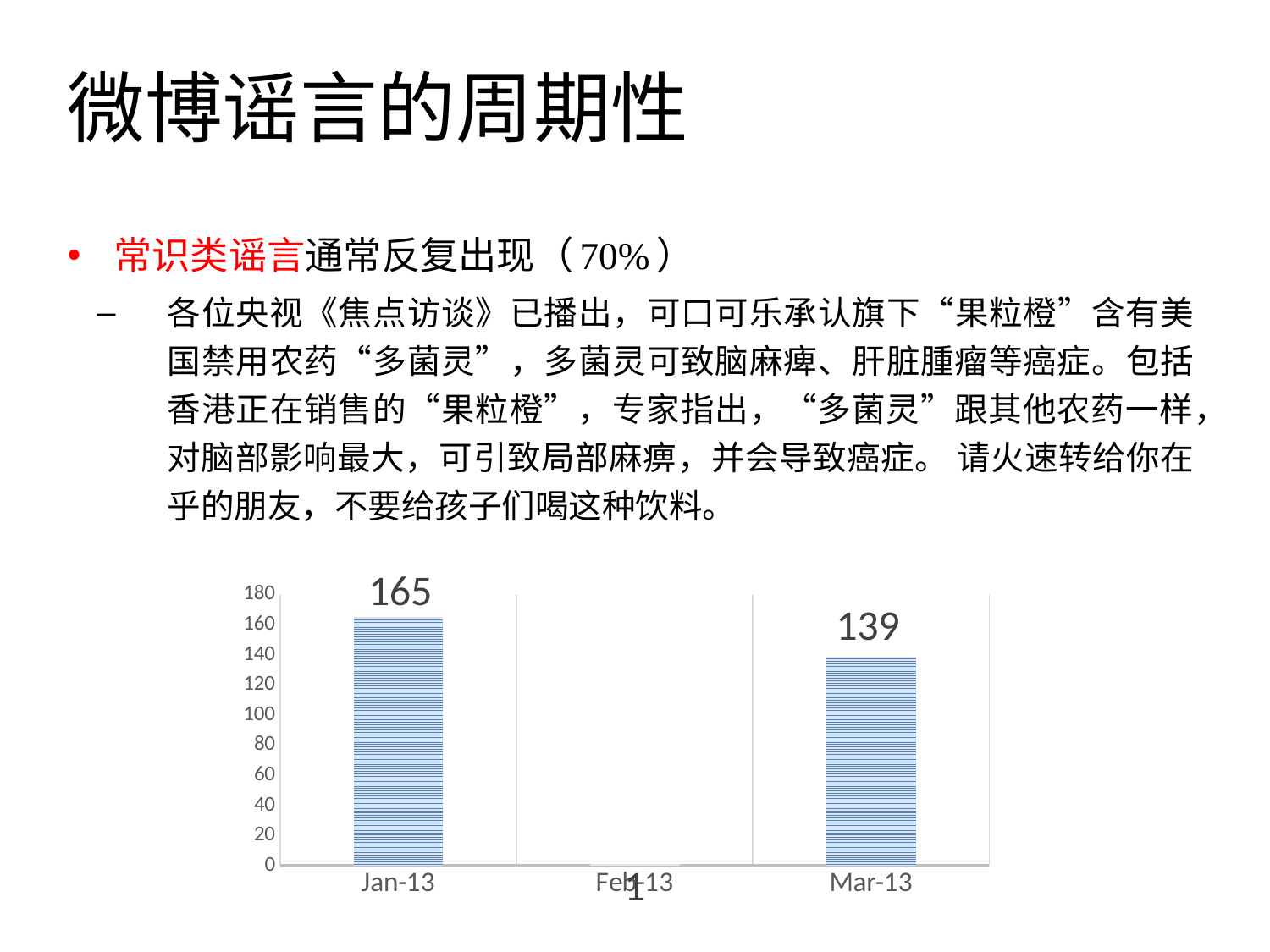
What is the value for Mar-13 in the bar chart? 139 What is the value for Jan-13 in the bar chart? 165 Which is larger, the value for Jan-13 or the value for Mar-13? Jan-13 What kind of chart is shown on the slide? bar chart Which month has the highest value in the bar chart? Jan-13 What is the difference between the values for Jan-13 and Mar-13? 26 Is the value for Jan-13 greater or less than 160? greater Which month has the lowest value in the bar chart? Feb-13 What is the highest tick value shown on the y axis of the chart? 180 What are the category labels on the x axis of the chart? Jan-13, Feb-13, Mar-13 Is the value for Mar-13 greater or less than 120? greater How many categories are shown on the x axis of the bar chart? 3